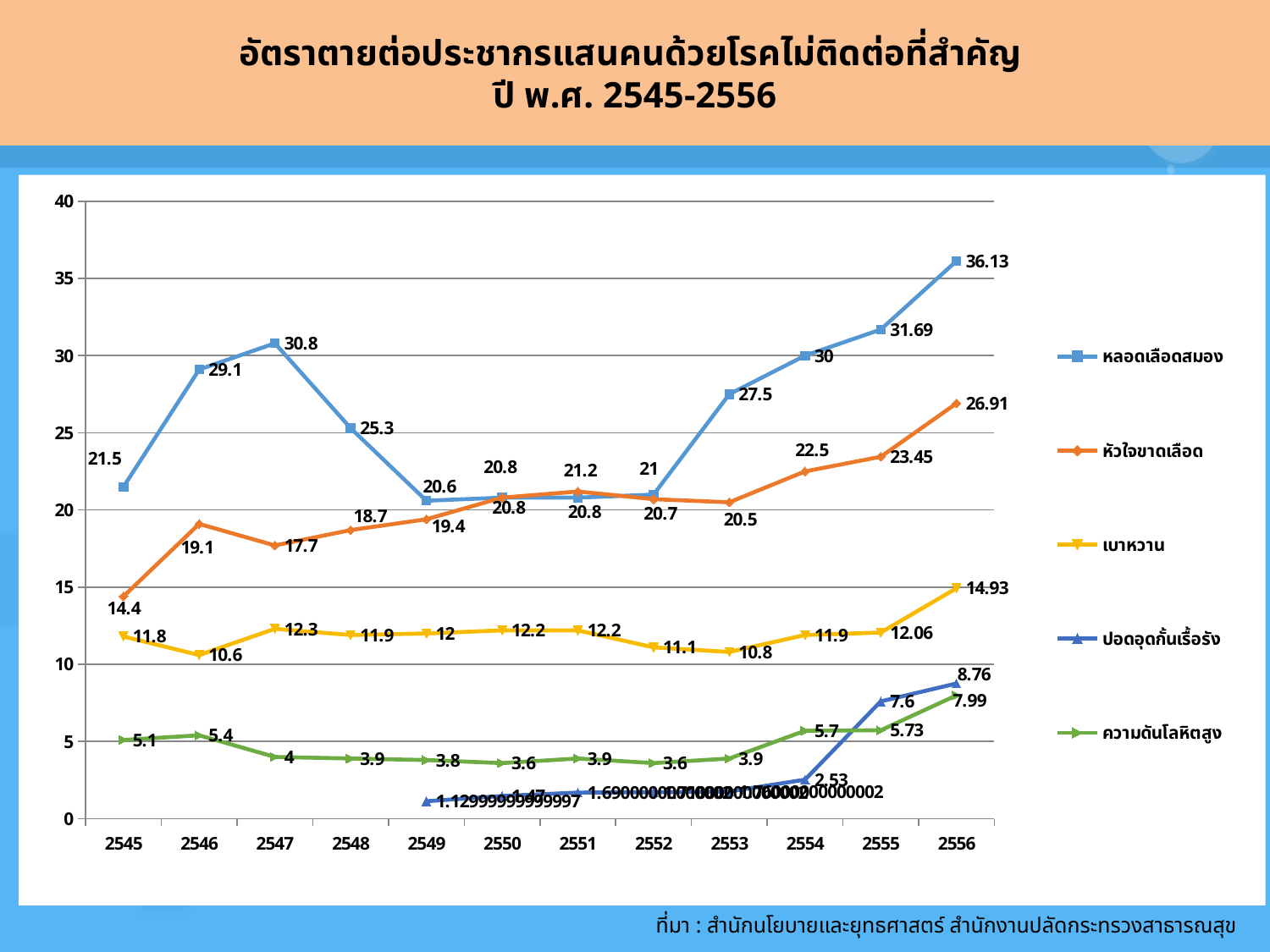
What is the value for เบาหวาน in 2553? 10.8 In which year is the value for หลอดเลือดสมอง the lowest? 2549 Does the value for หัวใจขาดเลือด rise or fall from 2553 to 2556? rise What type of chart is shown on the slide? line chart How many series does the legend list? 5 In which year is the value for ความดันโลหิตสูง the highest? 2556 What is the value for หลอดเลือดสมอง in 2556? 36.13 Is the value for เบาหวาน in 2556 greater or less than 15? less What is the value for หัวใจขาดเลือด in 2545? 14.4 What is the difference between the หลอดเลือดสมอง values in 2556 and 2555? 4.44 How many years are shown on the x axis? 12 Which series has the higher value in 2547: หลอดเลือดสมอง or หัวใจขาดเลือด? หลอดเลือดสมอง